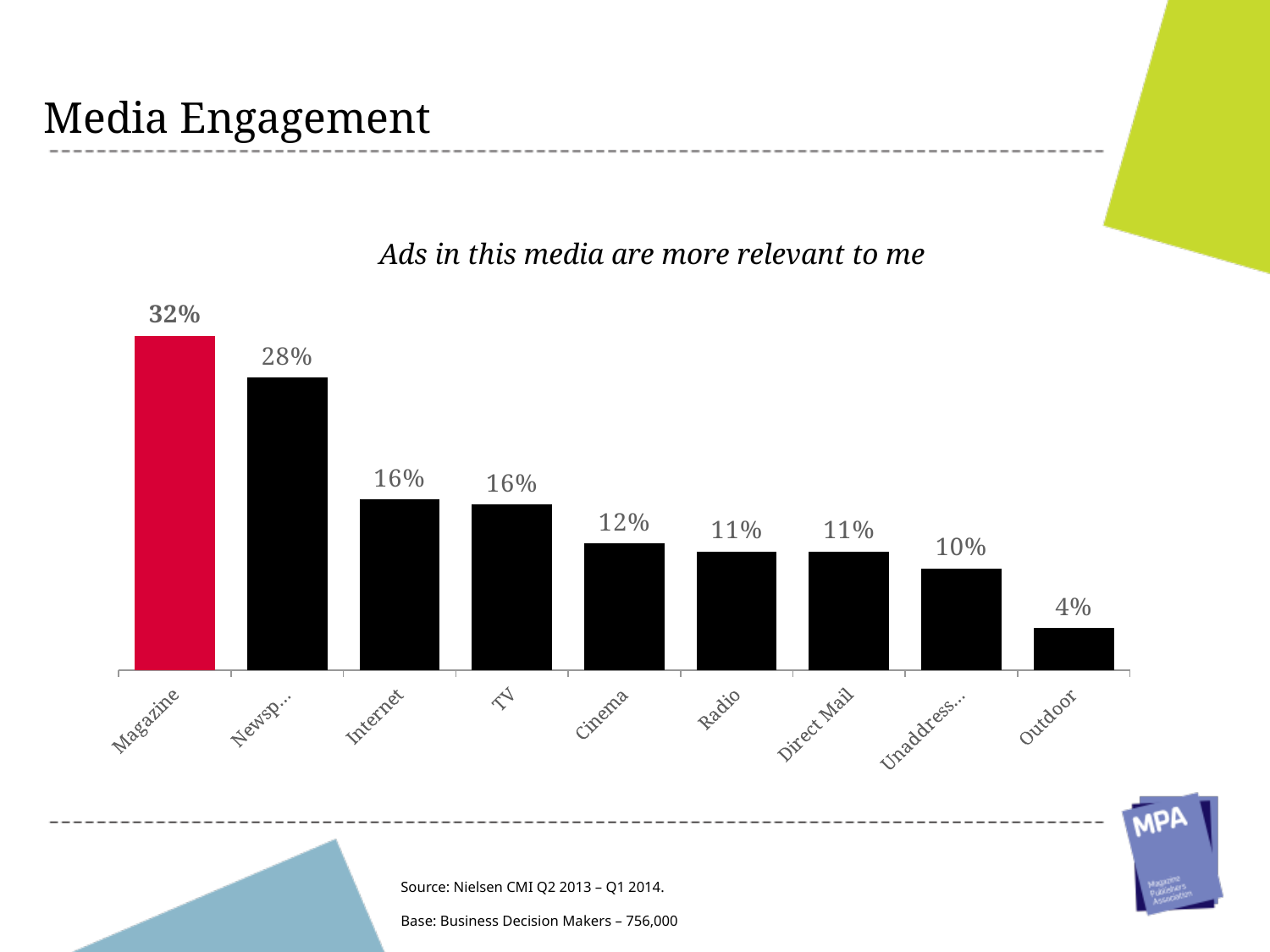
What is the value for Cinema? 12% What is the value for Outdoor? 4% Which category has the highest value? Magazine What is the value for Magazine? 32% What is the value for Internet? 16% Which is larger, the value for Internet or the value for Cinema? Internet What is the difference between the values for Magazine and TV? 16% What kind of chart is shown on the slide? Bar chart Which category has the lowest value? Outdoor What is the title of the chart? Ads in this media are more relevant to me What is the difference between the values for Radio and Outdoor? 7% How many categories are shown in the chart? 9